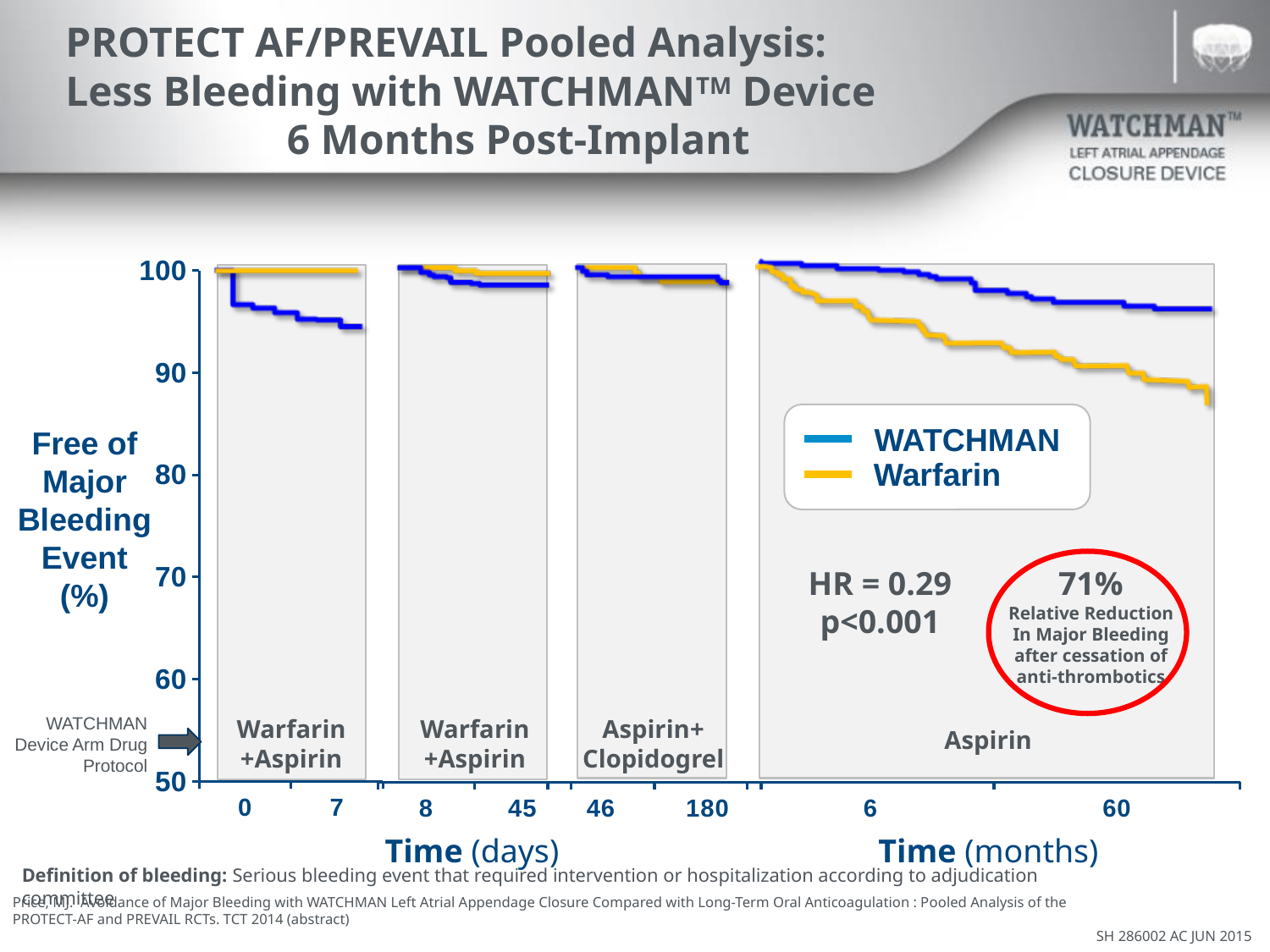
How many time panels does the chart have? 4 At the end of the Time (months) panel, is the value for WATCHMAN greater or less than 90? greater At the end of the Time (months) panel, is the value for Warfarin greater or less than 90? less At the end of the Time (months) panel, which series has the higher value, WATCHMAN or Warfarin? WATCHMAN What relative reduction in major bleeding is highlighted in the red circle? 71% At day 7 in the first panel, is the value for WATCHMAN greater or less than 90? greater In the first panel (days 0 to 7), which series has the lower value, WATCHMAN or Warfarin? WATCHMAN What hazard ratio is printed on the chart? HR = 0.29 What kind of chart is shown on the slide? line chart Do the values for both series rise or fall along the x axis? fall How many series does the legend list? 2